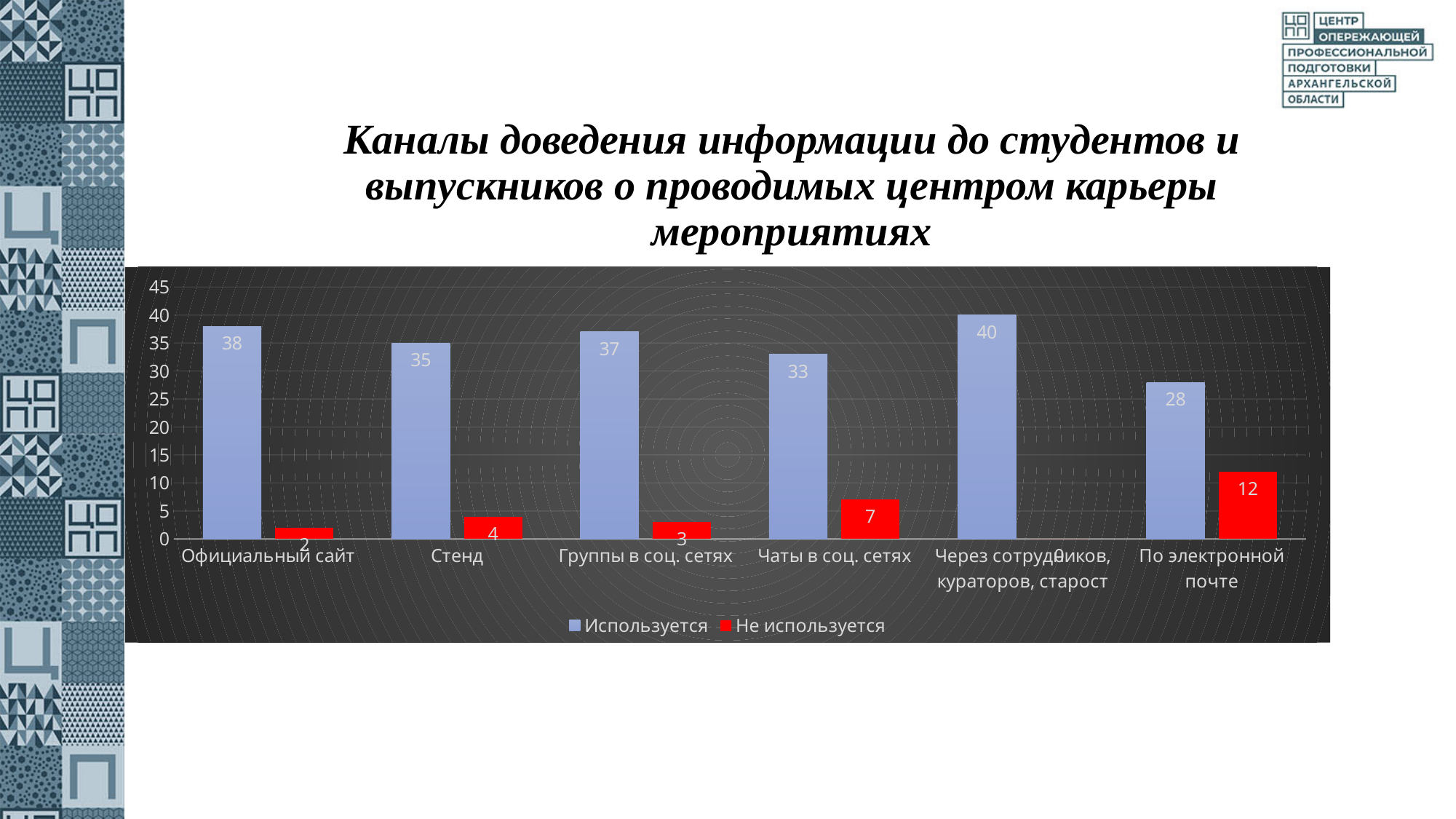
What is the value of "Используется" for "Официальный сайт"? 38 What is the value of "Не используется" for "По электронной почте"? 12 How many categories are shown on the x axis? 6 Which category has the lowest "Используется" value? По электронной почте Which category has the highest "Используется" value? Через сотрудников, кураторов, старост What colour are the bars for the "Не используется" series? Red How many series does the legend list? 2 Which is larger: the "Не используется" value for "Чаты в соц. сетях" or for "Стенд"? Чаты в соц. сетях What is the difference between the "Используется" values for "Официальный сайт" and "Стенд"? 3 What is the value of "Используется" for "Чаты в соц. сетях"? 33 Which category has the highest "Не используется" value? По электронной почте What kind of chart is shown on the slide? Bar chart